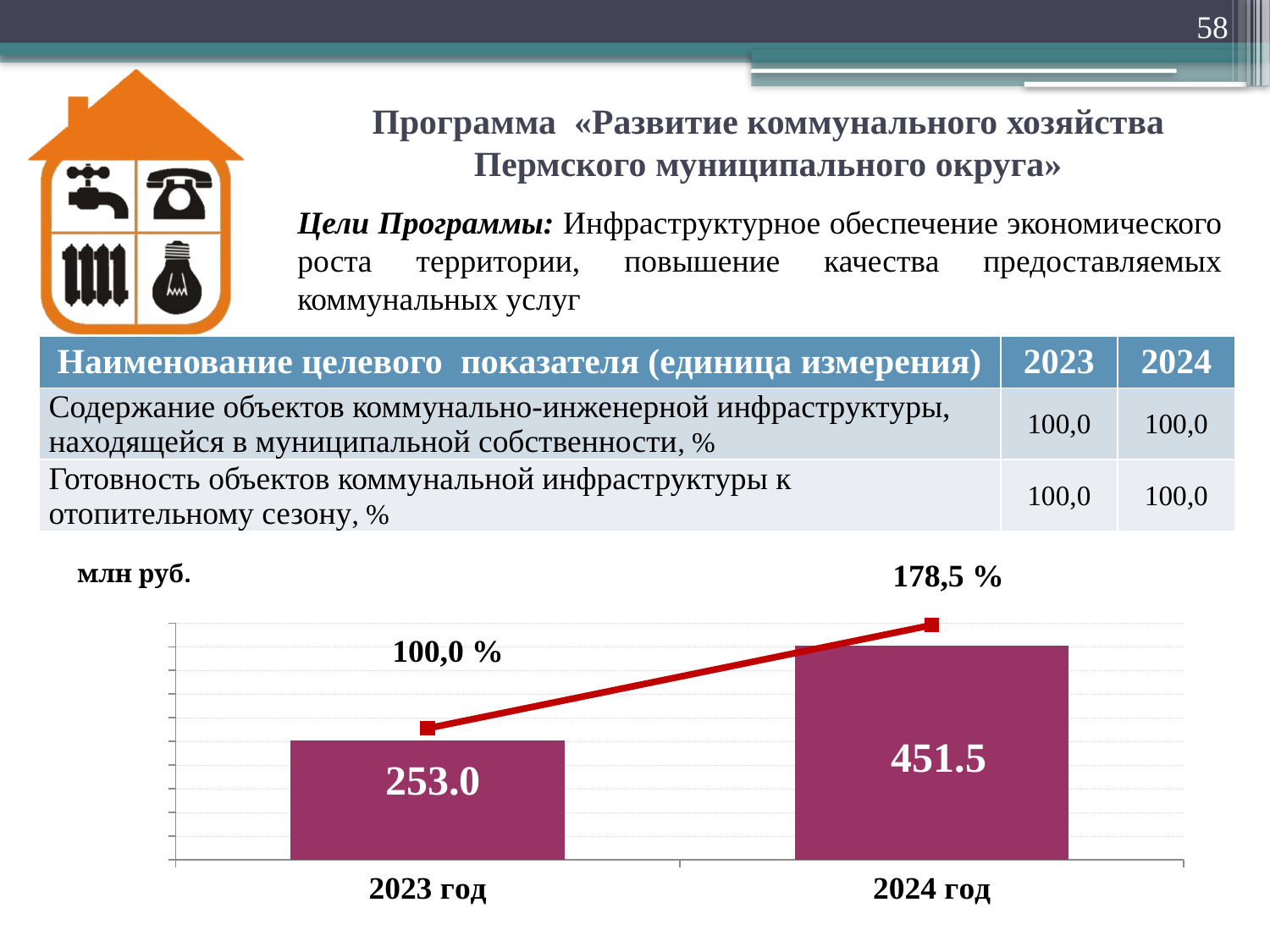
How many bars are plotted on the chart? 2 Which year has the higher bar value on the chart? 2024 год What percentage is shown on the line for 2024 год? 178,5 % Which year has the lower bar value on the chart? 2023 год Do the bar values rise or fall from 2023 год to 2024 год? rise What unit is indicated above the chart? млн руб. What kind of chart is shown on the slide? bar chart with a line Is the bar value for 2024 год larger or smaller than the bar value for 2023 год? larger What is the value for 2023 год on the chart? 253.0 What percentage is shown on the line for 2023 год? 100,0 % What is the value for 2024 год on the chart? 451.5 What is the difference between the bar values for 2024 год and 2023 год? 198.5